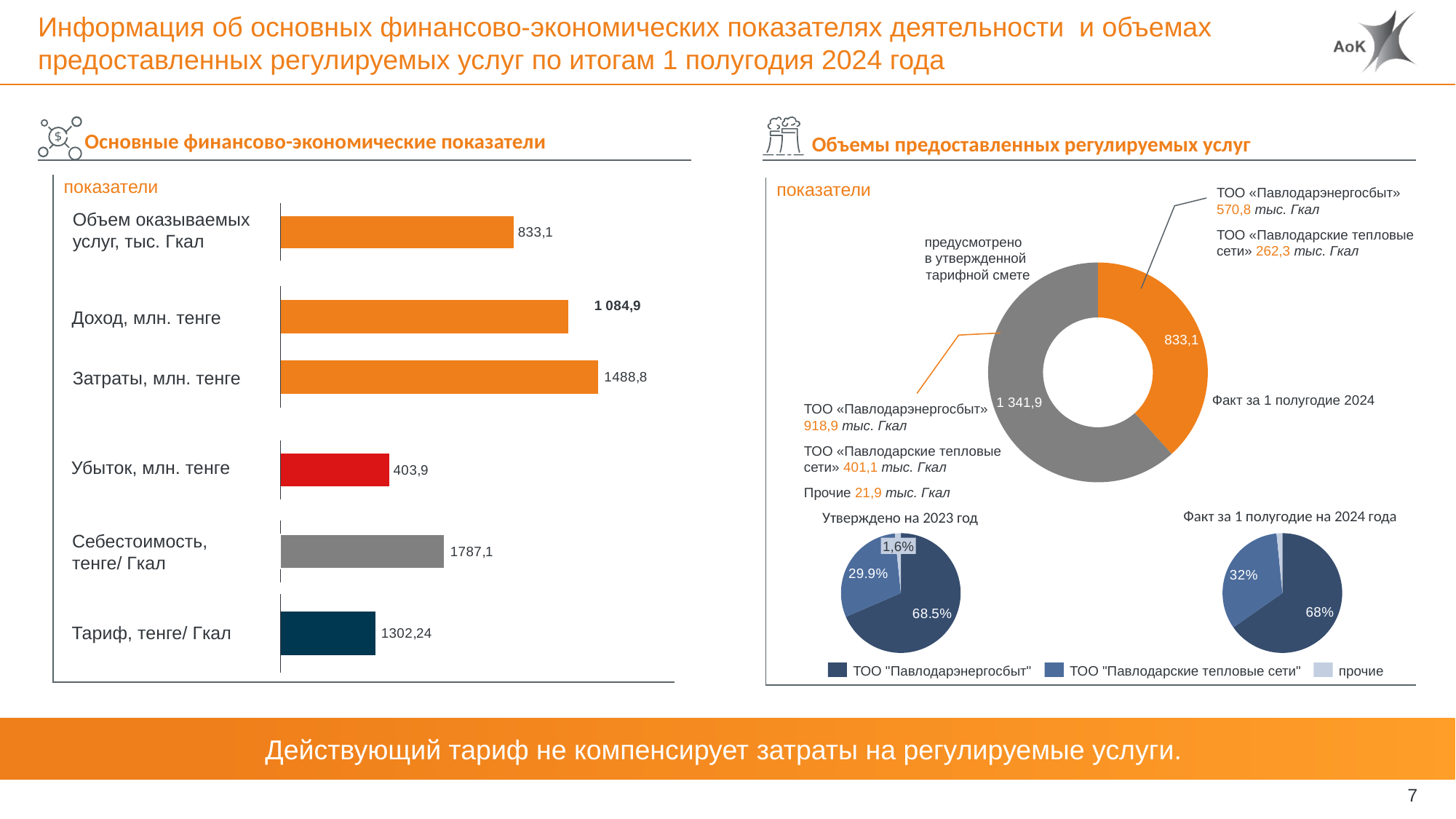
In the bar chart 'Основные финансово-экономические показатели', which is larger: 'Тариф, тенге/ Гкал' or 'Себестоимость, тенге/ Гкал'? Себестоимость, тенге/ Гкал In the bar chart 'Основные финансово-экономические показатели', what is the value for 'Затраты, млн. тенге'? 1488,8 In the bar chart 'Основные финансово-экономические показатели', which category has the longest bar? Затраты, млн. тенге In the donut chart under 'Объемы предоставленных регулируемых услуг', what is the value for 'Факт за 1 полугодие 2024'? 833,1 What kind of chart is used for 'Основные финансово-экономические показатели'? Bar chart In the bar chart 'Основные финансово-экономические показатели', what is the value for 'Тариф, тенге/ Гкал'? 1302,24 How many categories are shown in the bar chart 'Основные финансово-экономические показатели'? 6 In the bar chart 'Основные финансово-экономические показатели', what is the difference between 'Затраты, млн. тенге' and 'Доход, млн. тенге'? 403,9 In the pie chart 'Утверждено на 2023 год', what share does ТОО "Павлодарэнергосбыт" have? 68.5% In the bar chart 'Основные финансово-экономические показатели', which category has the shortest bar? Тариф, тенге/ Гкал In the donut chart under 'Объемы предоставленных регулируемых услуг', what is the value for 'предусмотрено в утвержденной тарифной смете'? 1 341,9 How many entries does the legend below the two pie charts list? 3